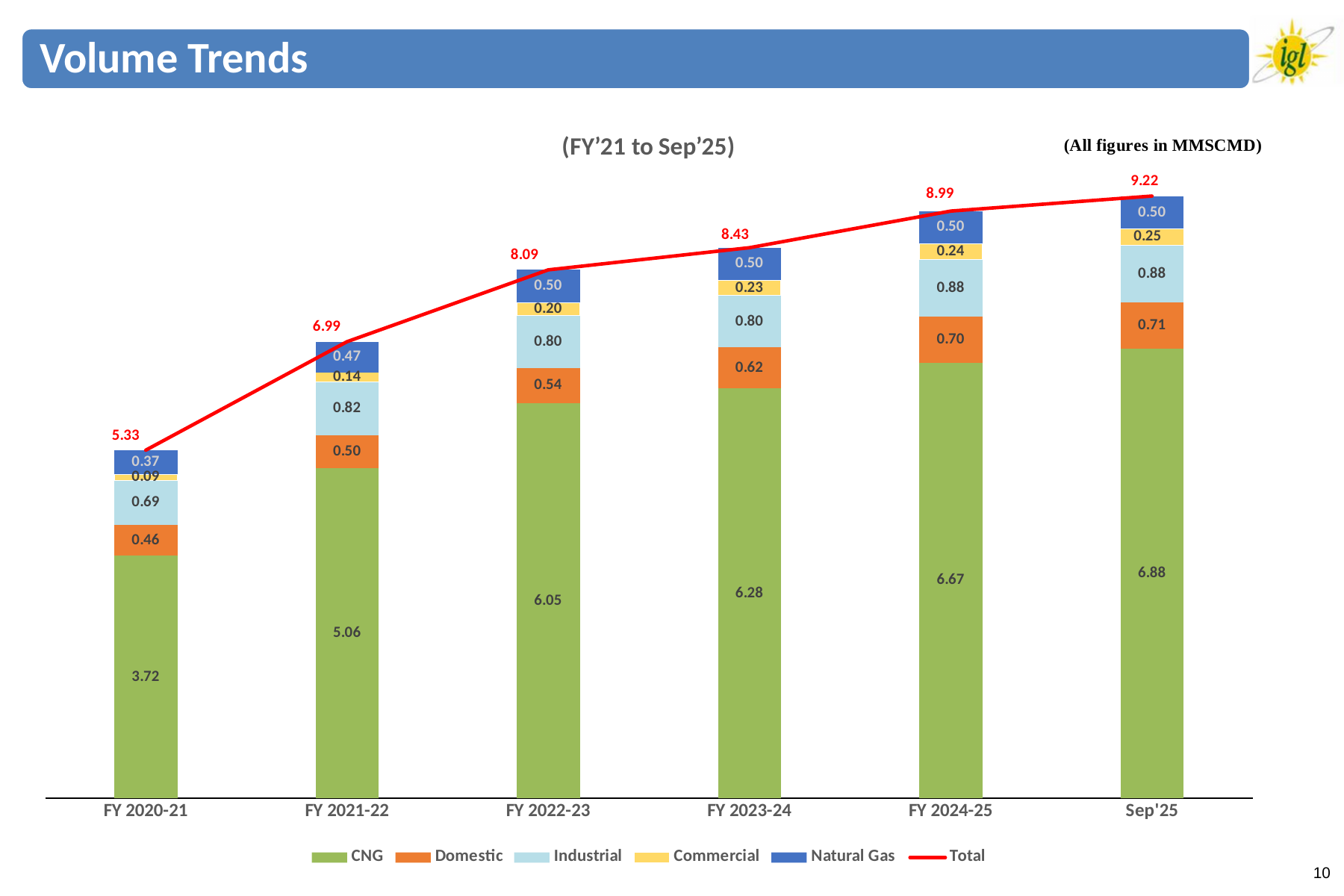
What is the Industrial value for FY 2020-21? 0.69 How many series does the legend list? 6 How many periods are shown on the x axis? 6 What kind of chart is this? Stacked bar chart with a line What is the difference between the Total for Sep'25 and the Total for FY 2020-21? 3.89 Which period has the lowest CNG value? FY 2020-21 What is the Domestic value for Sep'25? 0.71 Does the Total line rise or fall from FY 2020-21 to Sep'25? Rise What is the Total value for FY 2023-24? 8.43 Which is larger, the Commercial value for FY 2024-25 or the Commercial value for FY 2021-22? FY 2024-25 What is the CNG value for FY 2022-23? 6.05 Which period has the highest Total value? Sep'25